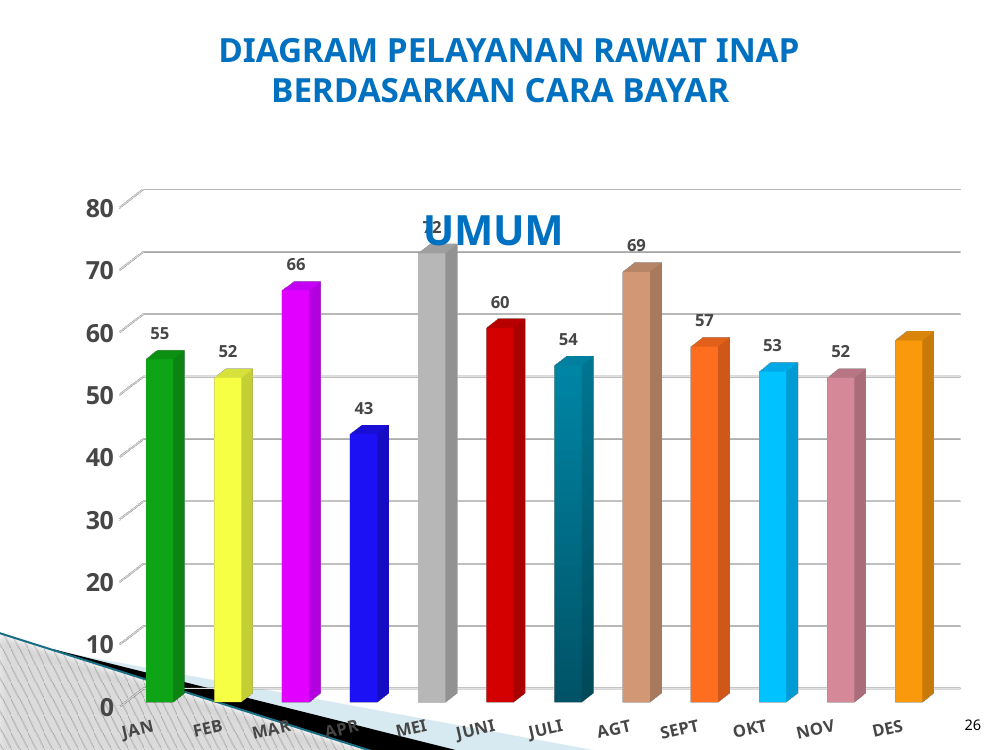
What is the title printed inside the chart area? UMUM What is the value for MAR? 66 What kind of chart is shown on the slide? bar chart What is the difference between the values for MAR and APR? 23 Which month has the lowest value? APR What is the value for APR? 43 Which is larger, the value for JAN or the value for JULI? JAN How many months are shown on the x axis? 12 Which month has the highest value? MEI What is the value for AGT? 69 Is the value for DES greater or less than 50? greater What is the value for JUNI? 60